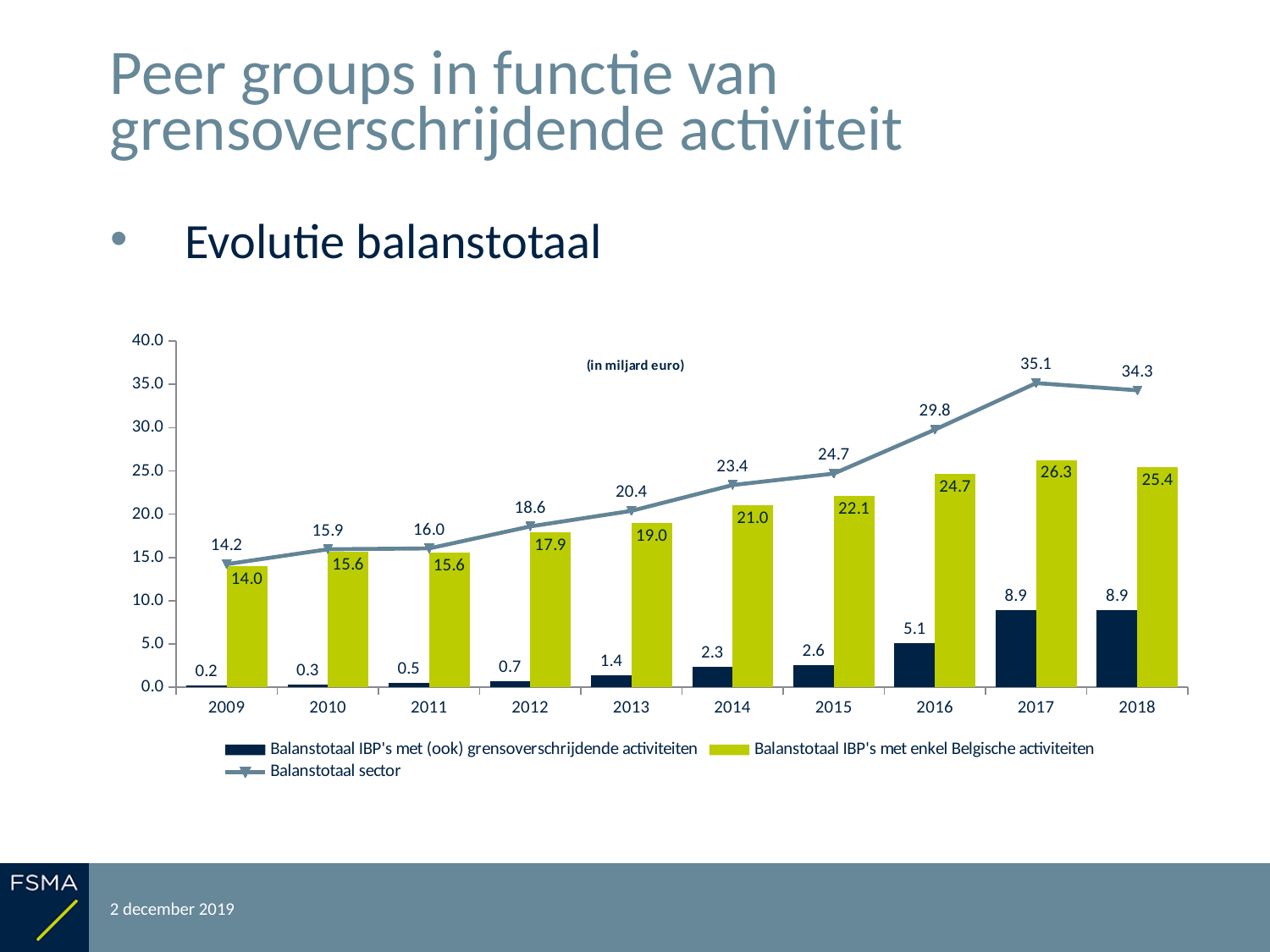
What is the value of 'Balanstotaal IBP's met (ook) grensoverschrijdende activiteiten' in 2016? 5.1 How many series does the legend list? 3 What is the value of 'Balanstotaal IBP's met enkel Belgische activiteiten' in 2014? 21.0 Is the value of 'Balanstotaal sector' in 2016 greater or less than 25.0? greater In which year is 'Balanstotaal IBP's met enkel Belgische activiteiten' lowest? 2009 Which is larger: 'Balanstotaal IBP's met enkel Belgische activiteiten' in 2017 or in 2018? 2017 What kind of chart is shown on the slide? Combined bar and line chart What is the difference between 'Balanstotaal sector' in 2018 and in 2009? 20.1 Does 'Balanstotaal IBP's met (ook) grensoverschrijdende activiteiten' rise or fall from 2009 to 2017? Rise What is the value of 'Balanstotaal sector' in 2017? 35.1 In which year is 'Balanstotaal sector' highest? 2017 How many years are shown on the x axis? 10